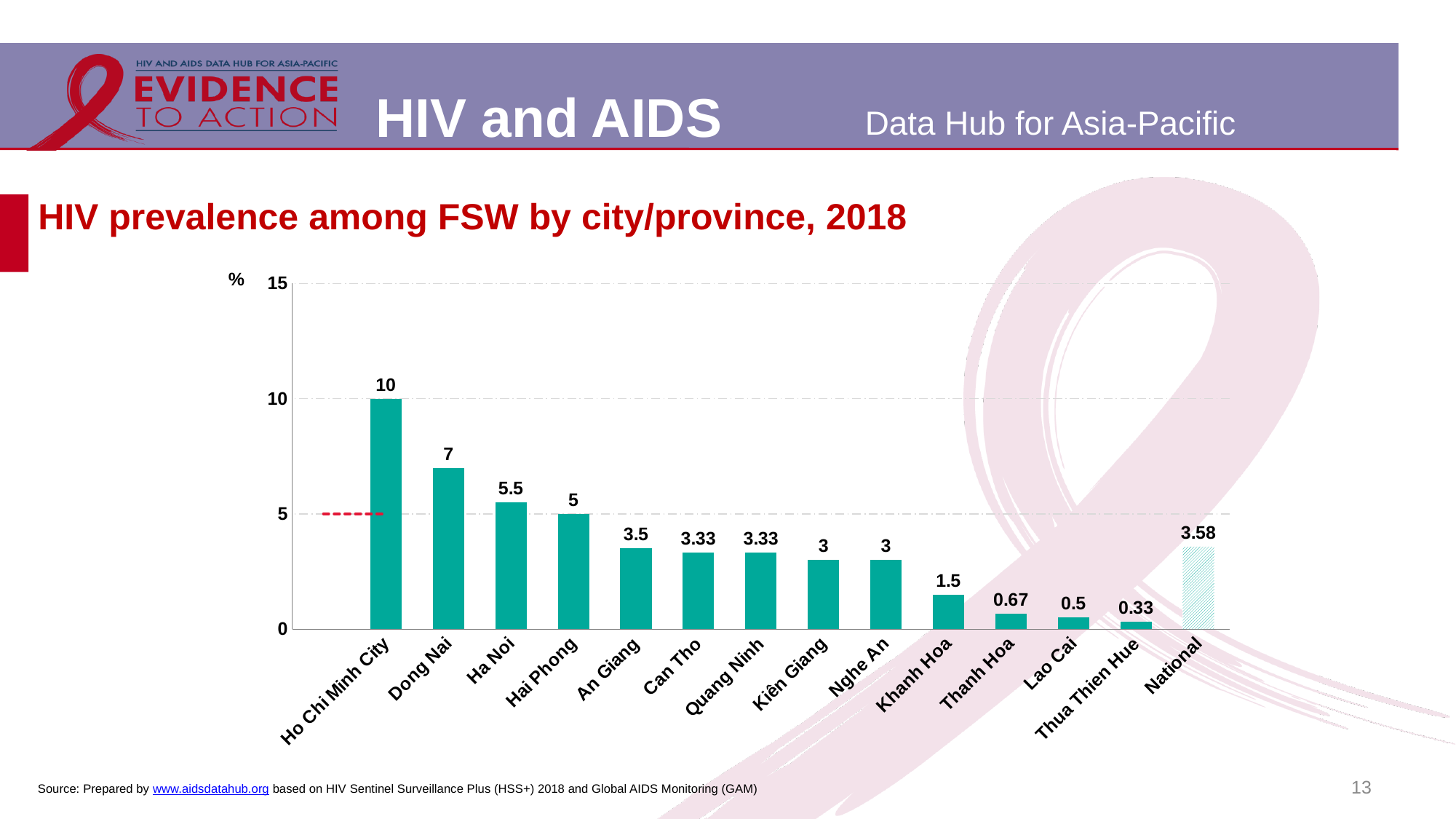
What kind of chart is shown on the slide? Bar chart What is the National value shown on the chart? 3.58 What is the value shown for Thua Thien Hue? 0.33 What is the difference between the values for Ho Chi Minh City and Dong Nai? 3 What is the HIV prevalence among FSW in Ho Chi Minh City? 10 Which city/province has the lowest HIV prevalence among FSW? Thua Thien Hue Which city/province has the highest HIV prevalence among FSW? Ho Chi Minh City Is the value for An Giang greater or less than 5? less How many bars are plotted on the chart, including National? 14 Which has a higher value, Ha Noi or Hai Phong? Ha Noi What is the value shown for Dong Nai? 7 What is the title of the chart? HIV prevalence among FSW by city/province, 2018